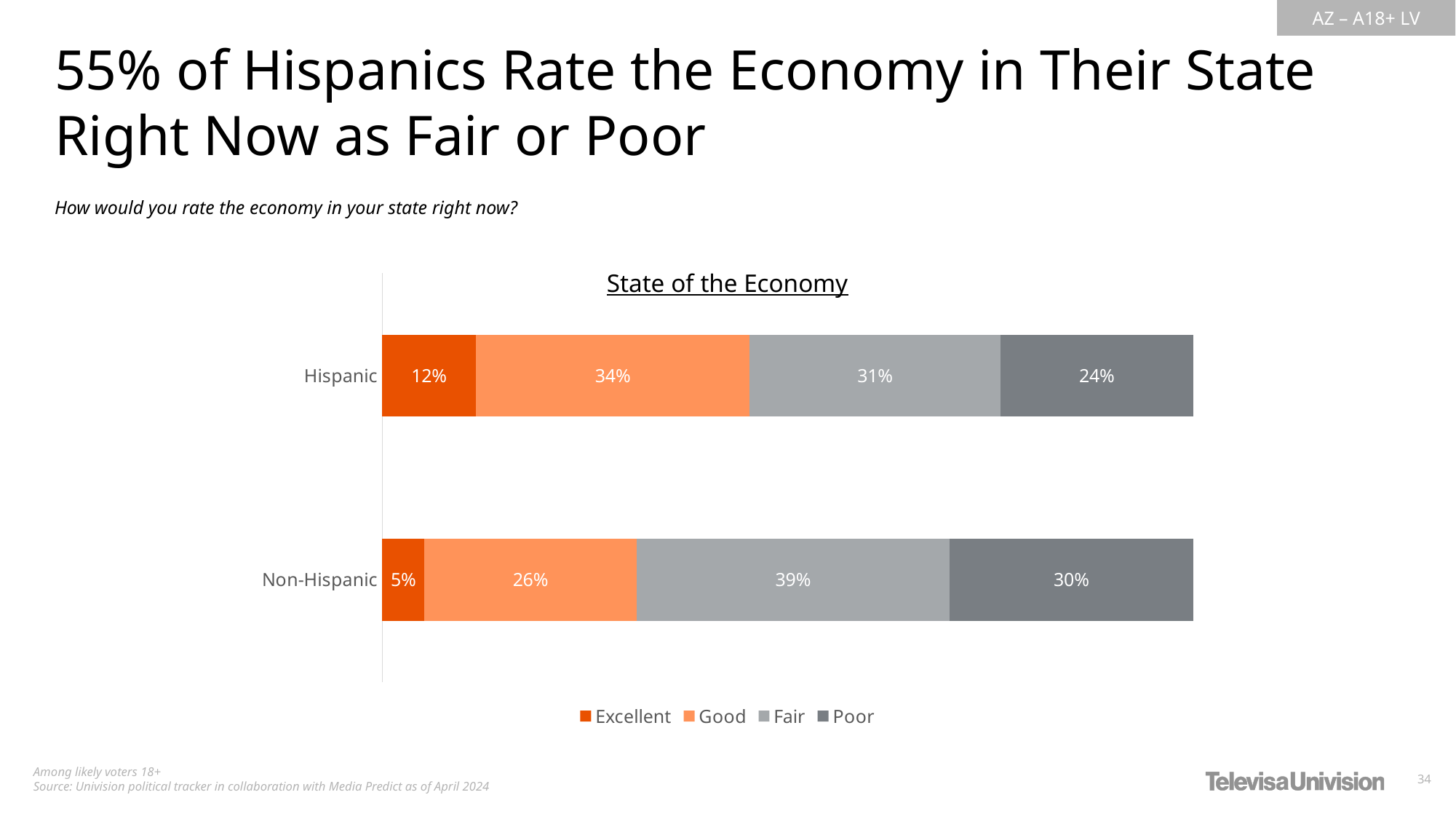
How many groups (bars) are shown in the chart? 2 What percentage of Non-Hispanic respondents rate the economy as Excellent? 5% What percentage of Non-Hispanic respondents rate the economy in their state as Fair? 39% What percentage of Hispanic respondents rate the economy in their state as Good? 34% Which group has a larger Poor share, Hispanic or Non-Hispanic? Non-Hispanic What type of chart is shown on the slide? Stacked bar chart What is the combined Fair and Poor share for Hispanic respondents? 55% Which rating has the largest share among Non-Hispanic respondents? Fair What percentage of Hispanic respondents rate the economy as Poor? 24% How many series does the legend list? 4 Which rating has the smallest share among Hispanic respondents? Excellent How many percentage points higher is the Good share for Hispanic respondents than for Non-Hispanic respondents? 8